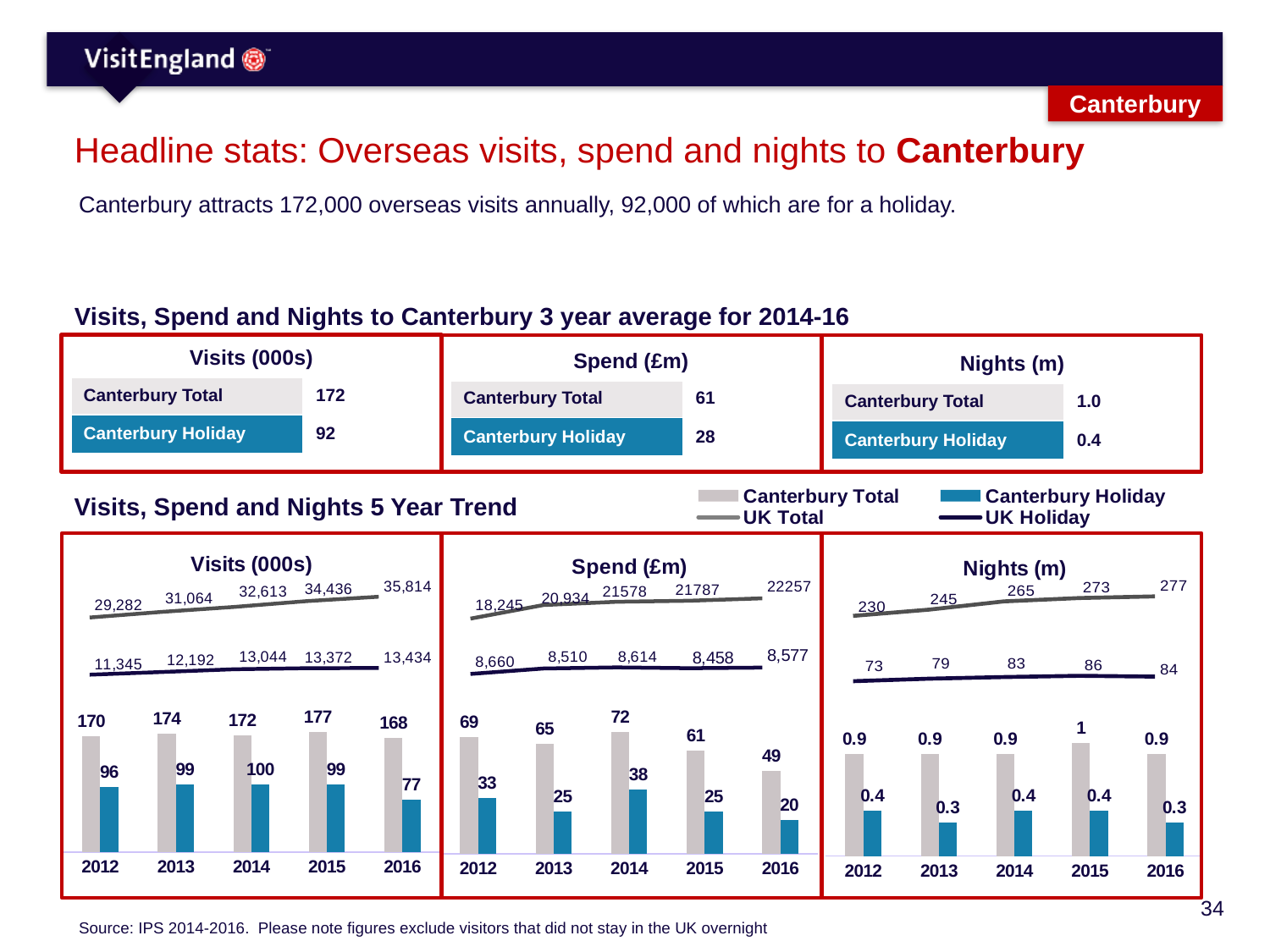
In the Visits (000s) 5 Year Trend chart, what is the UK Total value for 2016? 35,814 In the Spend (£m) 5 Year Trend chart, what is the difference between Canterbury Total and Canterbury Holiday spend in 2012? 36 In the Visits (000s) 5 Year Trend chart, what is the Canterbury Holiday value for 2016? 77 How many series does the legend for the 5 Year Trend charts list? 4 What kind of chart is used for the Canterbury Total and Canterbury Holiday values in the Nights (m) 5 Year Trend chart? bar chart In the Nights (m) 5 Year Trend chart, is the UK Holiday value larger in 2015 or 2016? 2015 In the Spend (£m) 5 Year Trend chart, which year has the highest Canterbury Total spend? 2014 In the Visits (000s) 5 Year Trend chart, what is the Canterbury Total value for 2015? 177 In the Visits (000s) 5 Year Trend chart, does the UK Total line rise or fall from 2012 to 2016? rise In the Nights (m) 5 Year Trend chart, what is the UK Total value for 2014? 265 How many years are shown on the x axis of the Spend (£m) 5 Year Trend chart? 5 In the Spend (£m) 5 Year Trend chart, which year has the lowest Canterbury Holiday spend? 2016